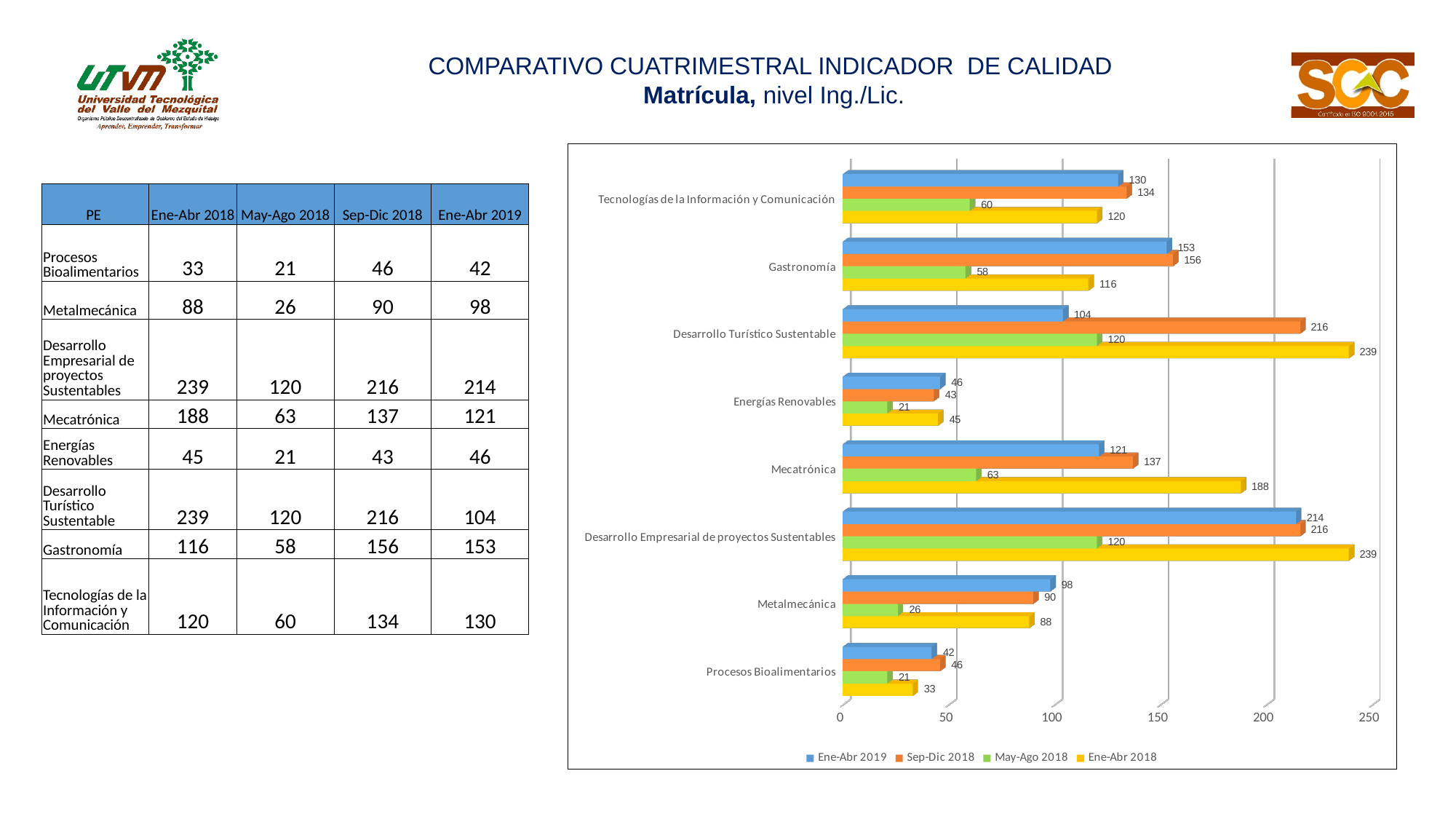
What is the May-Ago 2018 value for Metalmecánica? 26 Which category has the lowest Ene-Abr 2018 value? Procesos Bioalimentarios What is the difference between the Ene-Abr 2018 and Ene-Abr 2019 values for Desarrollo Turístico Sustentable? 135 What type of chart is shown on the slide? bar chart Which is larger for Energías Renovables: the Ene-Abr 2019 value or the Sep-Dic 2018 value? Ene-Abr 2019 How many categories (programs) are plotted on the chart? 8 What is the Ene-Abr 2019 value for Mecatrónica? 121 What is the Sep-Dic 2018 value for Gastronomía? 156 How many series does the chart legend list? 4 Which category has the highest Ene-Abr 2019 value? Desarrollo Empresarial de proyectos Sustentables Is the Sep-Dic 2018 value for Mecatrónica greater or less than 100? greater Which series is shown in yellow in the chart legend? Ene-Abr 2018